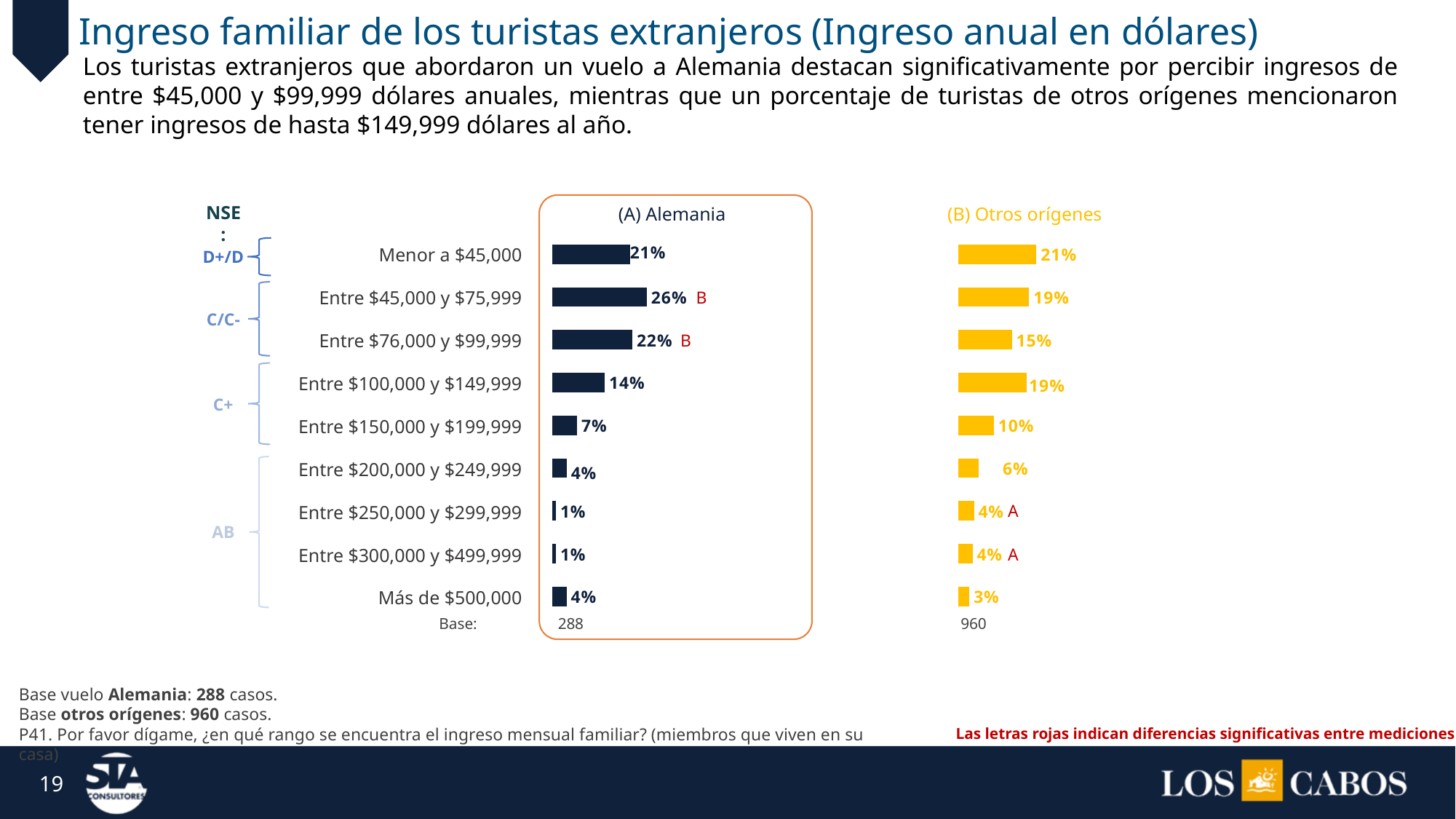
In the (B) Otros orígenes chart, which income range has the lowest percentage? Más de $500,000 How many income ranges are shown in the (A) Alemania chart? 9 In the (A) Alemania chart, which income range has the highest percentage? Entre $45,000 y $75,999 In the (A) Alemania chart, what percentage of tourists reported income of Más de $500,000? 4% What is the difference between the (A) Alemania and (B) Otros orígenes values for the income range Entre $76,000 y $99,999? 7% What type of chart is used to show the (B) Otros orígenes data? Bar chart What colour are the bars in the (B) Otros orígenes chart? Yellow What is the base (number of cases) shown for the (A) Alemania chart? 288 In the (A) Alemania chart, what percentage of tourists reported income between $45,000 and $75,999? 26% In the (B) Otros orígenes chart, what is the value for Menor a $45,000? 21% In the (B) Otros orígenes chart, what percentage of tourists reported income between $100,000 and $149,999? 19% For the income range Entre $150,000 y $199,999, which chart shows the larger value, (A) Alemania or (B) Otros orígenes? (B) Otros orígenes